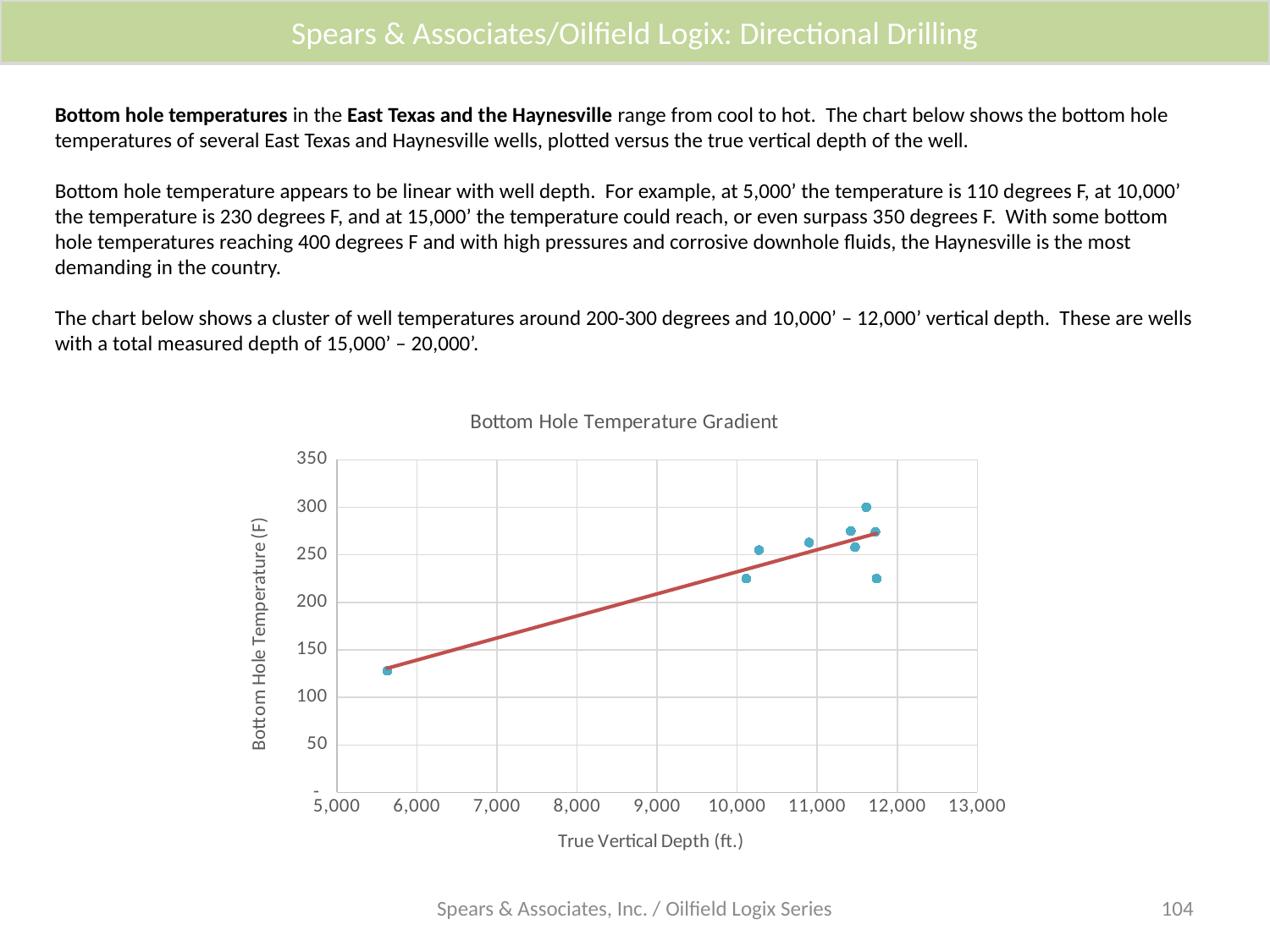
Is the bottom hole temperature of the shallowest well (near 5,600 ft) greater or less than 150? less Is the lowest bottom hole temperature plotted greater or less than 100? greater Is the highest bottom hole temperature plotted greater or less than 250? greater Which has the higher bottom hole temperature: the well near 5,600 ft or the well near 10,100 ft? The well near 10,100 ft What is the highest value shown on the y axis of the chart? 350 Do bottom hole temperatures rise or fall as true vertical depth increases along the x axis? Rise What is the title of the chart? Bottom Hole Temperature Gradient What kind of chart is shown on the slide? Scatter chart What is the label of the x axis of the chart? True Vertical Depth (ft.)